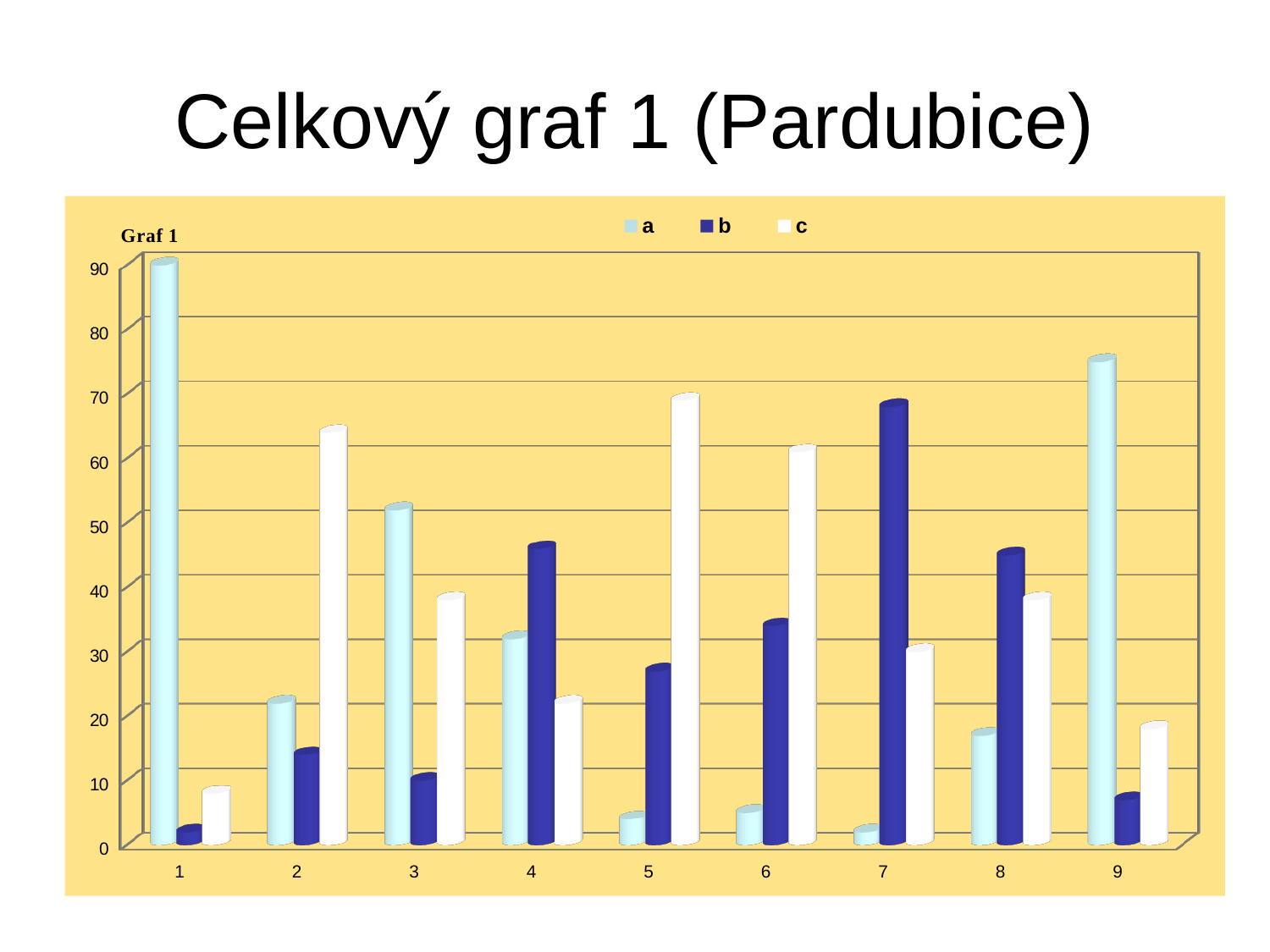
What are the names of the series listed in the legend? a, b, c Which category has the highest value for series c? 5 In category 3, which is larger: series a or series c? series a Which category has the highest value for series a? 1 How many series does the legend list? 3 Is the value for series a in category 9 greater or less than 70? greater Is the value for series c in category 2 greater or less than 60? greater What kind of chart is shown on the slide? bar chart Which category has the highest value for series b? 7 How many categories are shown on the x axis? 9 Is the value for series a in category 1 greater or less than 80? greater